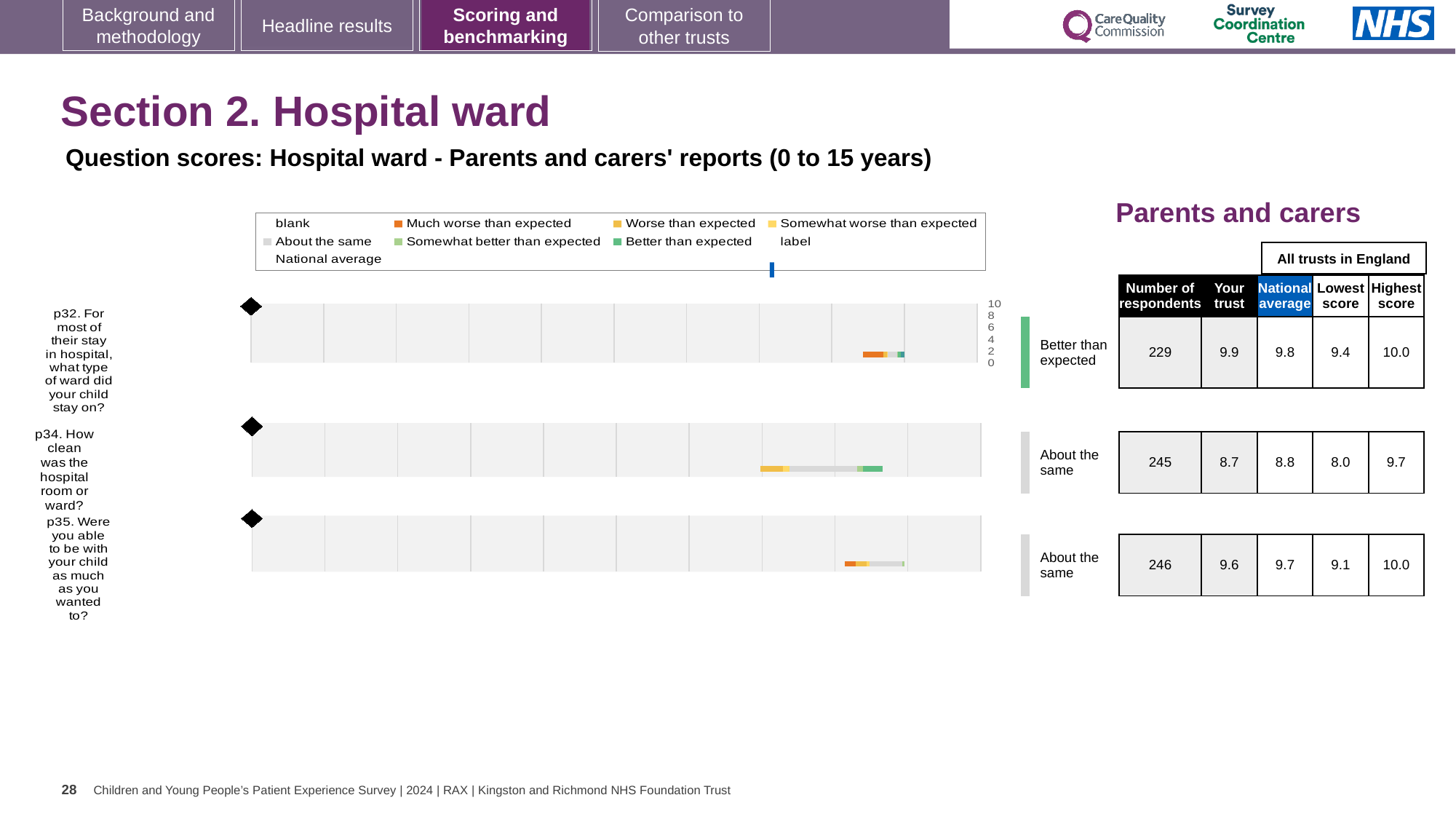
What benchmark category is shown for p32? Better than expected What is the national average score for p34 (how clean was the hospital room or ward)? 8.8 How many questions (p32, p34, p35) are plotted as separate bars on the slide? 3 For p32, which is larger: the 'Your trust' score or the national average? Your trust What is the 'Your trust' score for p32 (what type of ward did your child stay on)? 9.9 For p34, what is the difference between the highest score and the lowest score across all trusts in England? 1.7 Which legend entry is shown in orange? Much worse than expected Which question has the lowest number of respondents? p32 How many respondents answered p35 (were you able to be with your child as much as you wanted to)? 246 What is the highest score across all trusts in England for p34? 9.7 What kind of chart is used to show the question scores on this slide? bar chart Which question has the highest 'Your trust' score? p32